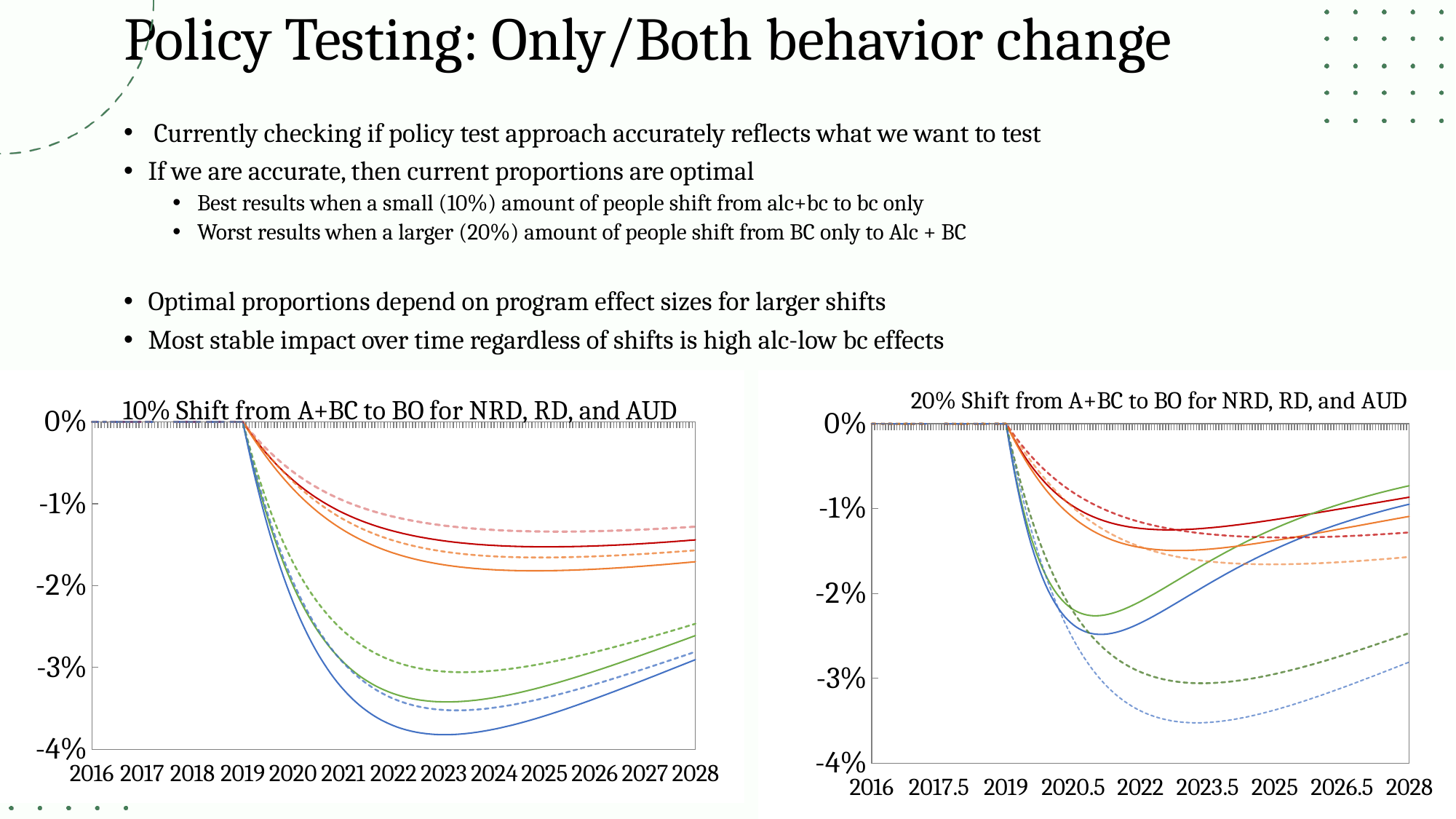
In the left chart, how many year labels are shown on the x axis? 13 What is the title of the right chart? 20% Shift from A+BC to BO for NRD, RD, and AUD In the right chart, is the lowest point of the dotted blue line greater or less than -3%? less In the right chart, at 2028, which is lower: the dotted blue line or the dotted green line? dotted blue line In the right chart, is the value of the solid green line at 2028 greater or less than -1%? greater In the left chart, does the solid blue line rise or fall between 2023 and 2028? rise In the left chart, is the value of the solid red line at 2028 greater or less than -1%? less In the left chart, at 2028, which is lower: the solid blue line or the solid green line? solid blue line In the left chart, in which year do the lines first start to drop below 0%? 2019 In the right chart, how many labels are shown on the x axis? 9 What type of chart is the left chart titled "10% Shift from A+BC to BO for NRD, RD, and AUD"? line chart